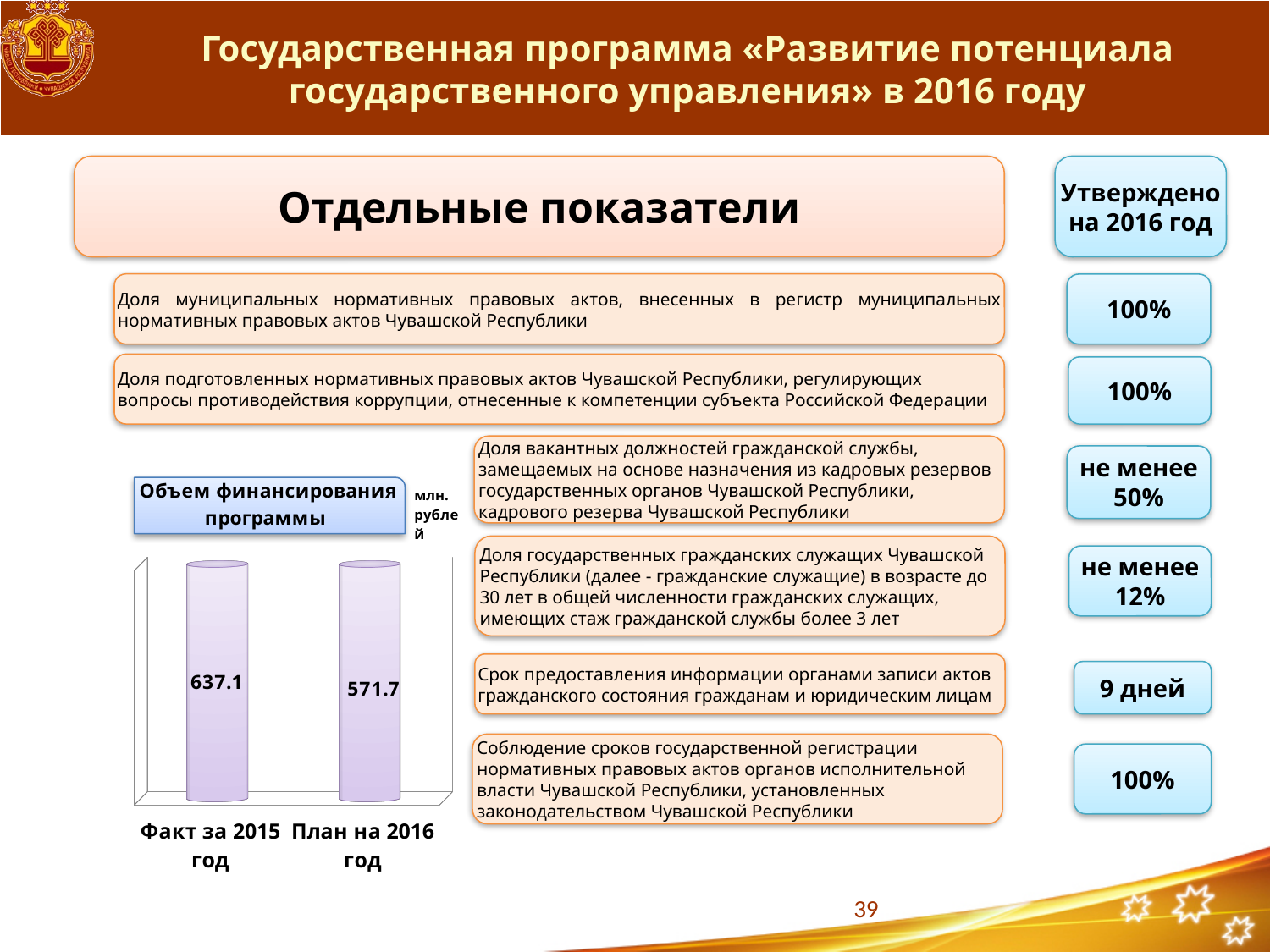
What is the value for «План на 2016 год» in the «Объем финансирования программы» chart? 571.7 What is the difference between the values for «Факт за 2015 год» and «План на 2016 год» in the «Объем финансирования программы» chart? 65.4 What is the title of the chart on the slide? Объем финансирования программы Do the values in the «Объем финансирования программы» chart rise or fall from «Факт за 2015 год» to «План на 2016 год»? Fall Which category has the highest value in the «Объем финансирования программы» chart? Факт за 2015 год What unit is indicated for the values in the «Объем финансирования программы» chart? млн. рублей In the «Объем финансирования программы» chart, which is larger: «Факт за 2015 год» or «План на 2016 год»? Факт за 2015 год Which category has the lowest value in the «Объем финансирования программы» chart? План на 2016 год What kind of chart is the «Объем финансирования программы» chart? Bar chart What is the value for «Факт за 2015 год» in the «Объем финансирования программы» chart? 637.1 How many categories are shown in the «Объем финансирования программы» chart? 2